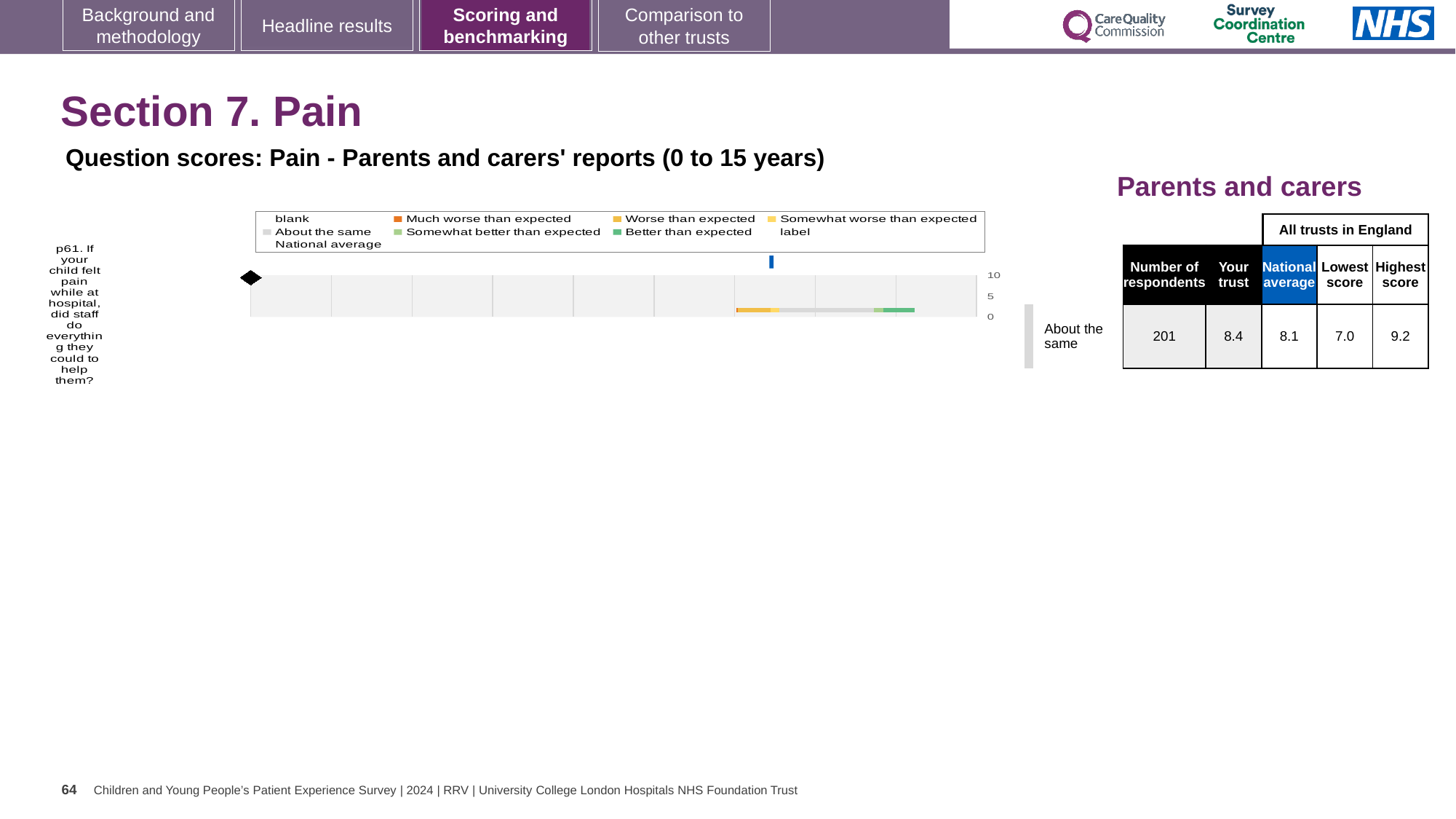
According to the table, how many respondents answered question p61? 201 How many entries does the chart legend list? 9 What is the question number of the item plotted in the chart? p61 According to the table, what is the lowest score among all trusts in England for question p61? 7.0 According to the table, what is the national average score for question p61? 8.1 How many survey questions are plotted in the chart? 1 Which is larger for question p61: the 'Your trust' score or the national average? Your trust What kind of chart is shown on the slide? bar chart What is the difference between the highest score and the lowest score for question p61 in the table? 2.2 According to the table, what is the highest score among all trusts in England for question p61? 9.2 According to the table, what is the 'Your trust' score for question p61? 8.4 What colour does the legend use for 'Better than expected'? green